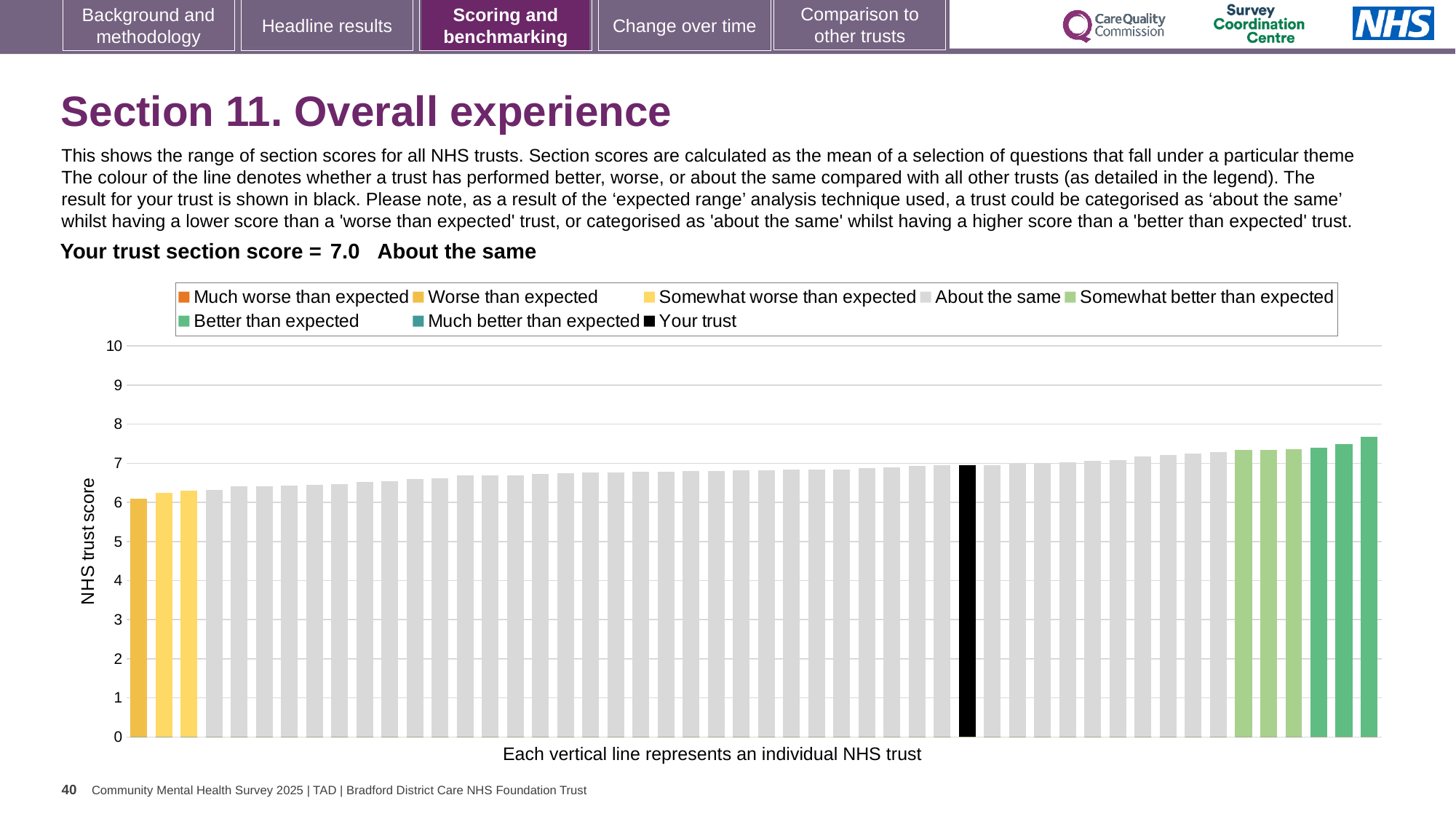
Which category is your trust placed in for this section? About the same What is the title of the vertical axis? NHS trust score Do the bar values rise or fall from left to right along the x axis? rise What kind of chart is shown on the slide? Bar chart Is the value of the shortest bar in the chart greater or less than 7? less Is the value of the black 'Your trust' bar greater or less than 8? less What colour is the bar representing your trust? Black Is the value of the black 'Your trust' bar greater or less than 6? greater How many entries does the chart legend list? 8 What is the section score for your trust shown on the slide? 7.0